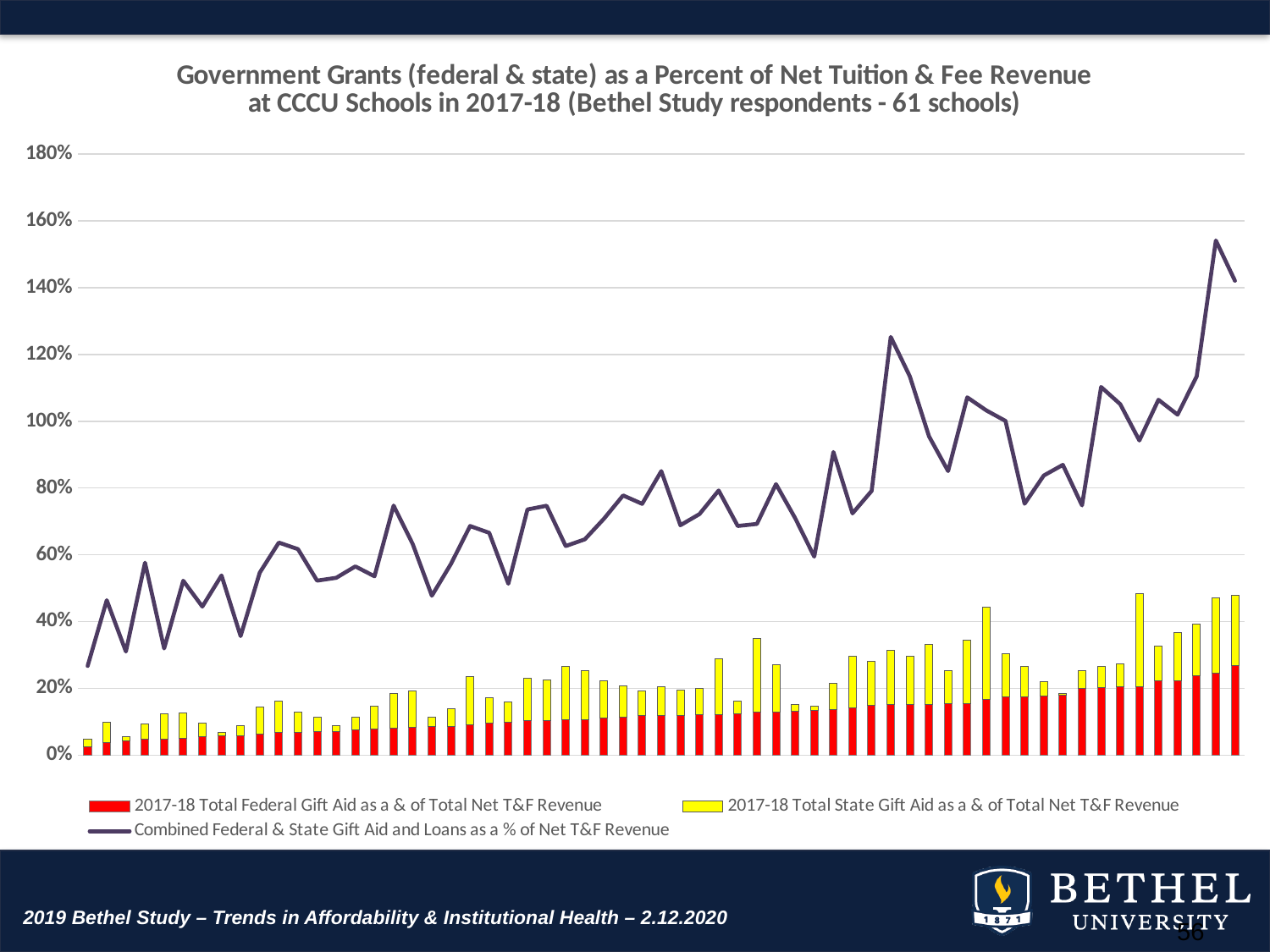
Is the lowest value of the Combined Federal & State Gift Aid and Loans line greater or less than 20%? greater How many schools are represented in the chart, according to the title? 61 What is the title of the chart? Government Grants (federal & state) as a Percent of Net Tuition & Fee Revenue at CCCU Schools in 2017-18 (Bethel Study respondents - 61 schools) How many series does the legend list? 3 Is the first (leftmost) value of the Combined Federal & State Gift Aid and Loans line greater or less than 40%? less Which colour represents the 2017-18 Total State Gift Aid series? Yellow Which is larger for the leftmost school: the Combined Federal & State Gift Aid and Loans line value or the stacked bar total? The Combined Federal & State Gift Aid and Loans line value Is the tallest stacked bar (federal plus state gift aid) greater or less than 60%? less What kind of chart is this? A combination of a stacked bar chart and a line chart Do the values of the Combined Federal & State Gift Aid and Loans line generally rise or fall from left to right? Rise